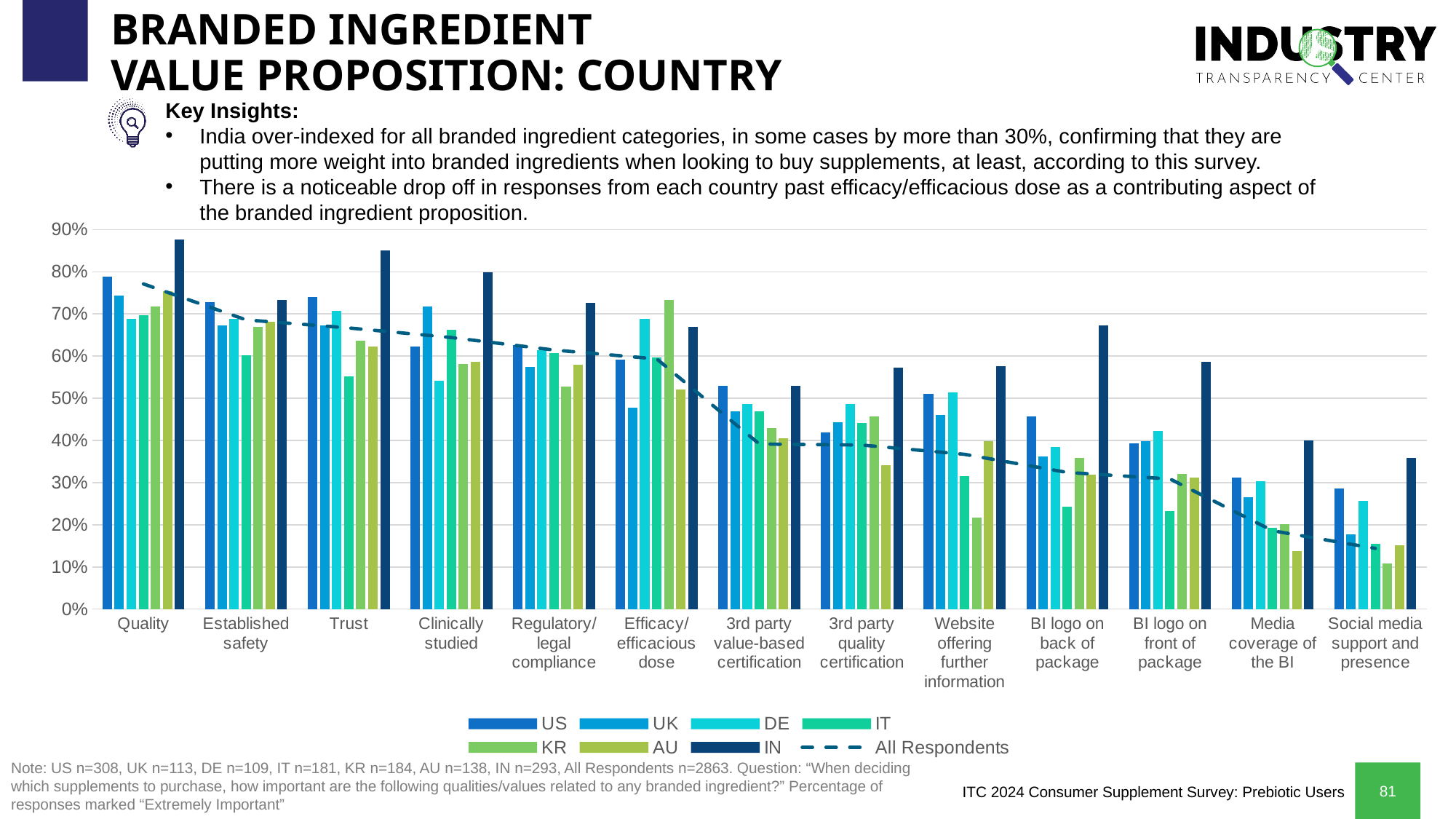
What kind of chart is shown on the slide? combination bar and line chart How many categories are shown along the x axis of the chart? 13 Which country has the lowest value for Social media support and presence? KR Is the value for IN on Quality greater or less than 80%? greater Does the All Respondents dashed line rise or fall from left to right across the categories? fall For Trust, which is larger: the value for IN or the value for US? IN Which legend entry is shown as a dashed line rather than bars? All Respondents Which country has the highest value for Quality? IN Is the value for DE on Efficacy/efficacious dose greater or less than 60%? greater Which country has the lowest value for Trust? IT Is the value for KR on Website offering further information greater or less than 30%? less How many entries does the chart legend list? 8